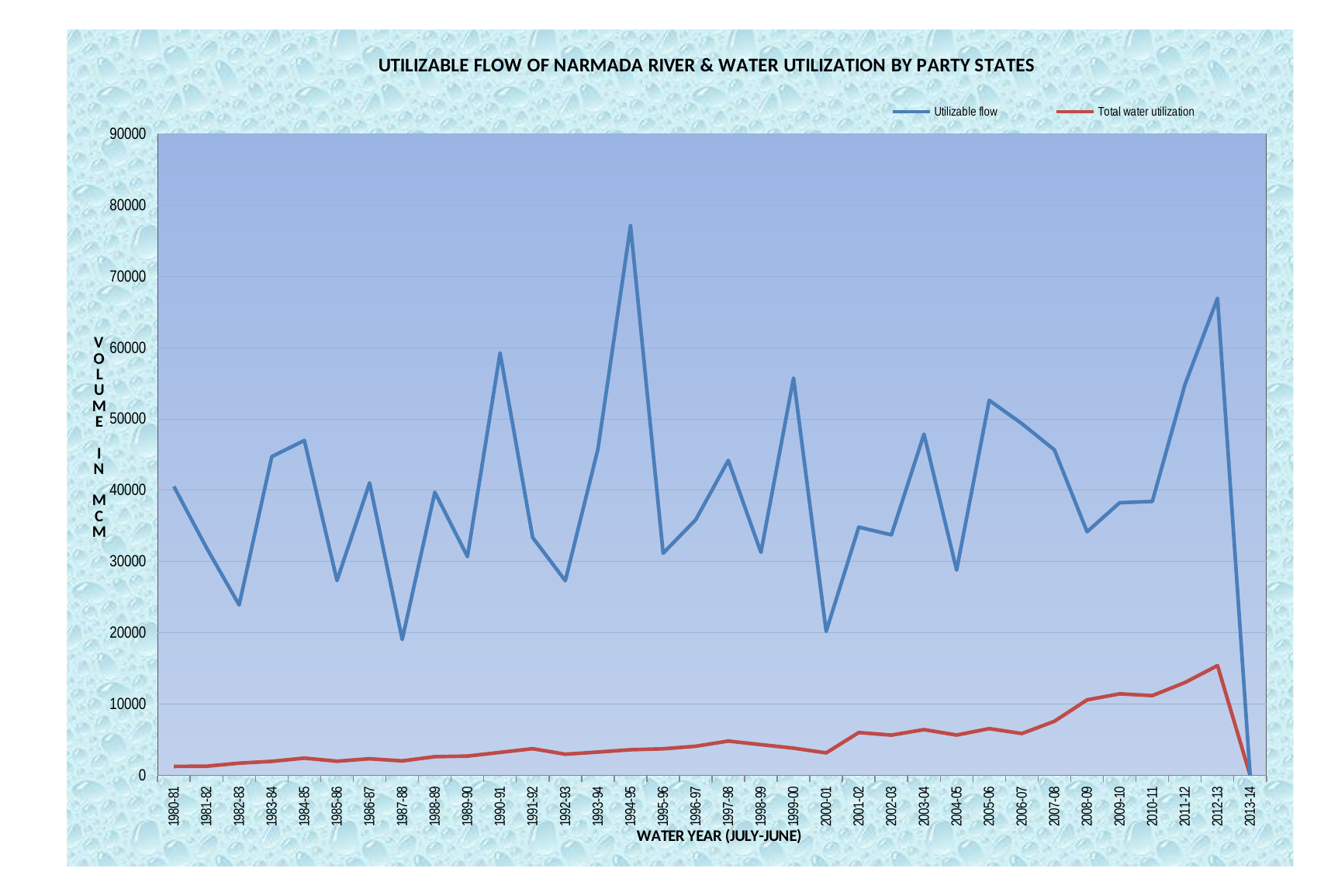
Does the Total water utilization generally rise or fall from 1980-81 to 2012-13? Rise Is the Utilizable flow for 1990-91 greater or less than 50000? greater Is the Utilizable flow for 1994-95 greater or less than 70000? greater What kind of chart is shown on the slide? Line chart Which is larger, the Utilizable flow in 1994-95 or in 2012-13? 1994-95 Is the Total water utilization for 2012-13 greater or less than 10000? greater How many water years are plotted along the x axis? 34 Which series is drawn in blue? Utilizable flow How many series does the legend list? 2 In which water year does the Total water utilization reach its highest value? 2012-13 In which water year does the Utilizable flow reach its highest value? 1994-95